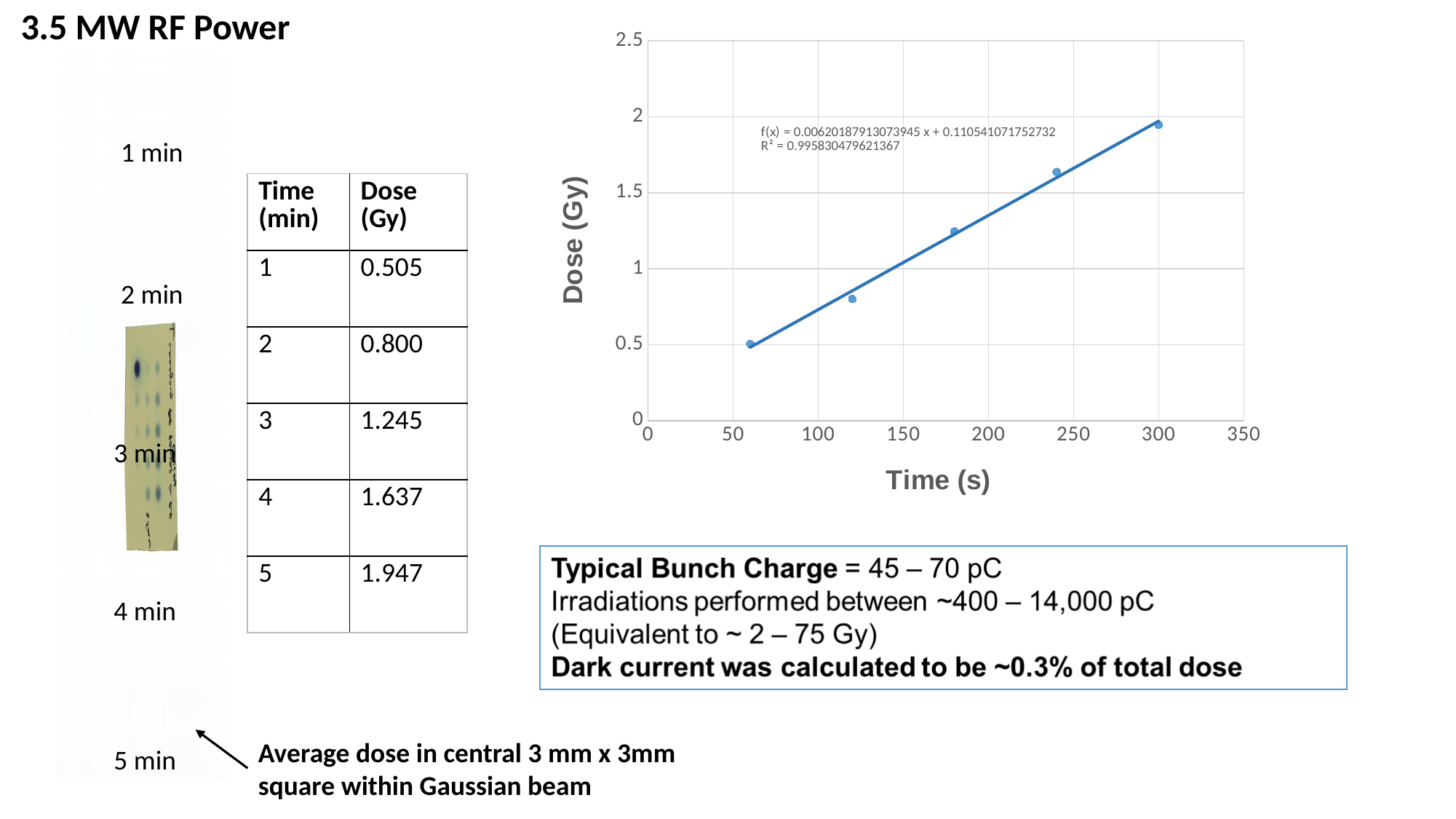
Which has the larger dose value, the point at 240 s or the point at 120 s? 240 s How many data points are plotted on the chart? 5 At which time (s) is the plotted dose lowest? 60 Do the plotted dose values rise or fall as time increases along the x axis? rise What R² value is printed on the chart for the fitted line? 0.995830479621367 At which time (s) is the plotted dose highest? 300 Is the dose value at 180 s greater or less than 1? greater What is the label of the chart's y axis? Dose (Gy) Is the dose value at 240 s greater or less than 1.5? greater Is the dose value at 300 s greater or less than 1.5? greater What kind of chart is shown on the slide? scatter chart